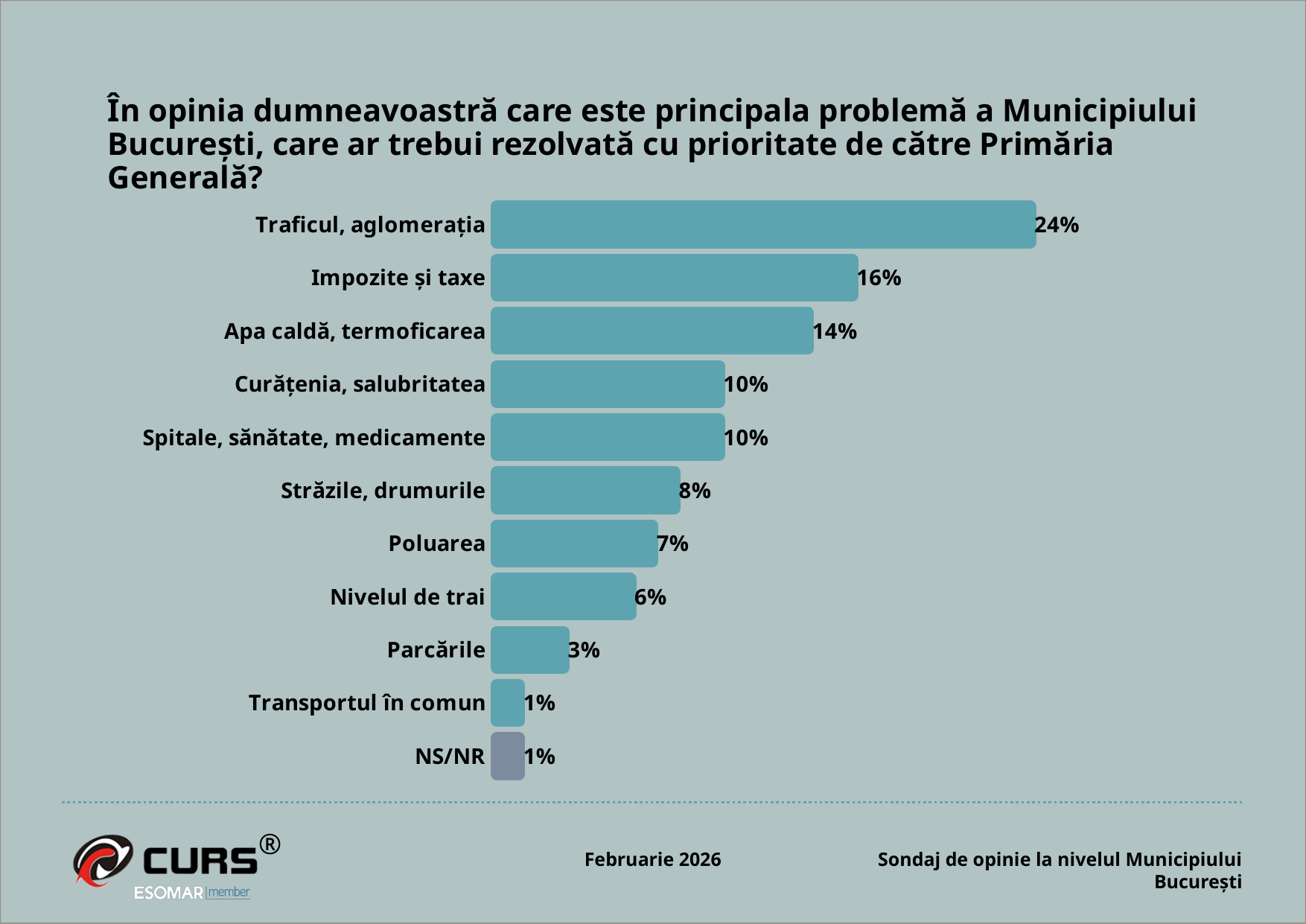
Which bar is shown in a different colour from the others? NS/NR What percentage of respondents named "Traficul, aglomerația" as the main problem? 24% What is the value shown for "Apa caldă, termoficarea"? 14% How many categories are shown on the chart? 11 What is the difference between the values for "Impozite și taxe" and "Străzile, drumurile"? 8% What kind of chart is shown on the slide? Bar chart Which two categories both have a value of 10%? Curățenia, salubritatea and Spitale, sănătate, medicamente What is the difference between the values for "Traficul, aglomerația" and "Impozite și taxe"? 8% Which is larger, the value for "Nivelul de trai" or the value for "Parcările"? Nivelul de trai Which category has the highest value on the chart? Traficul, aglomerația What month and year is shown at the bottom of the slide? Februarie 2026 What is the value shown for "Poluarea"? 7%